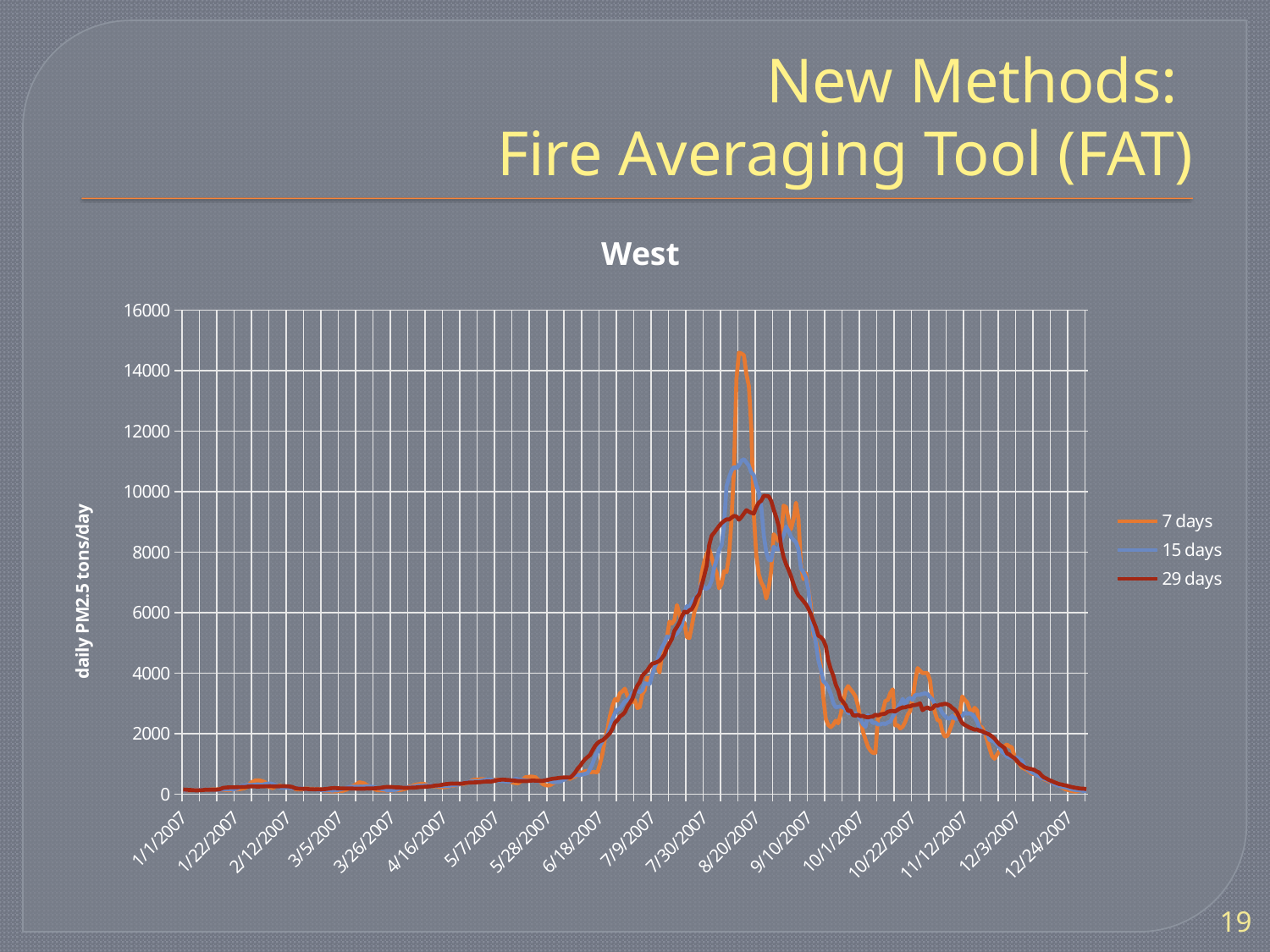
Between 6/18/2007 and 8/20/2007, does the 29 days series rise or fall? rise Which series reaches the highest peak value? 7 days What is the label on the vertical axis of the chart? daily PM2.5 tons/day What is the title of the chart? West What kind of chart is shown on the slide? line chart Is the peak value of the 7 days series greater or less than 14000? greater Between 11/12/2007 and 12/24/2007, does the 29 days series rise or fall? fall Is the peak value of the 15 days series greater or less than 10000? greater Is the value of the 29 days series on 1/1/2007 greater or less than 2000? less How many series does the legend list? 3 Which series has the lowest peak value? 29 days